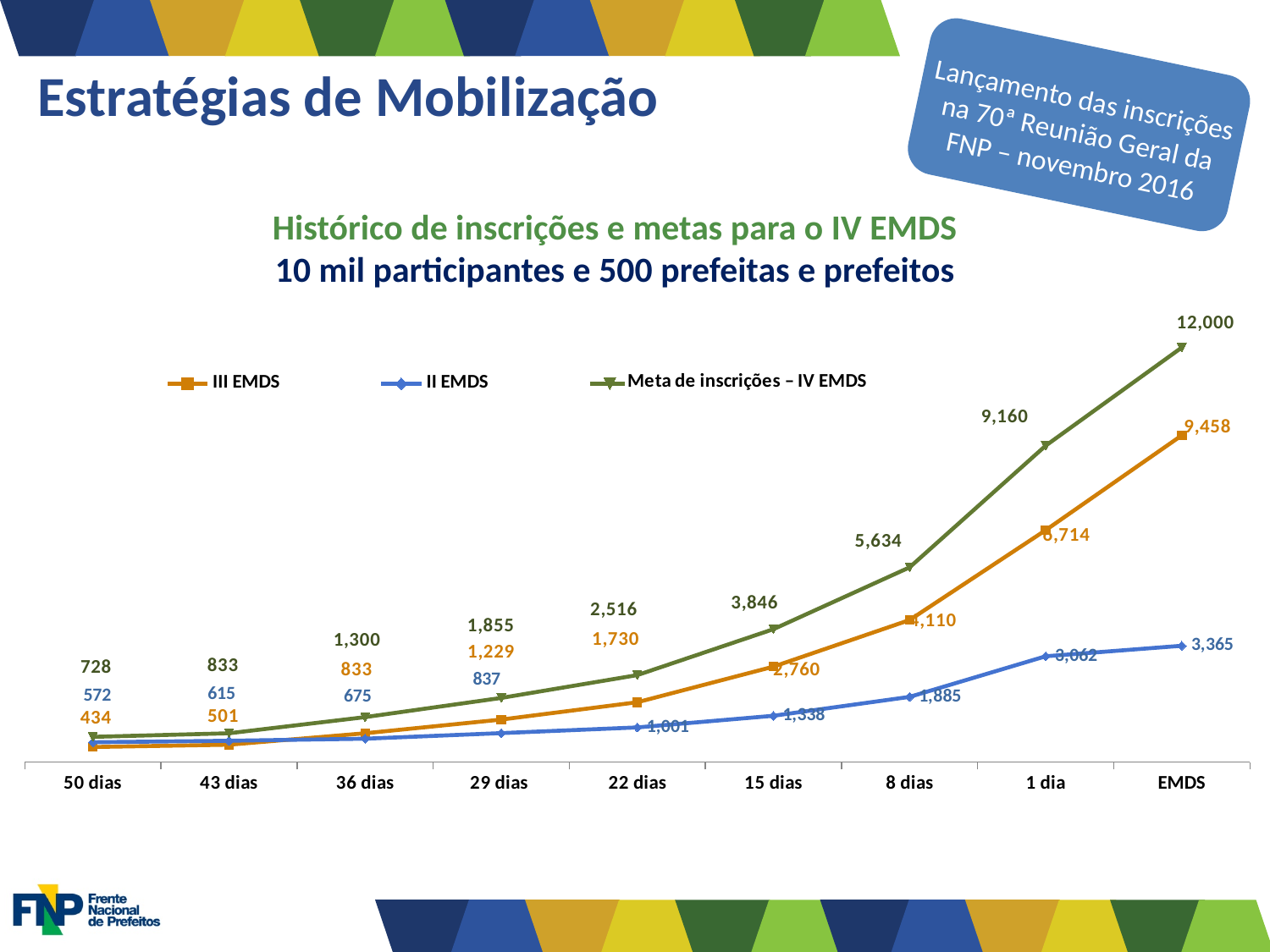
Does the Meta de inscrições – IV EMDS series rise or fall from 50 dias to EMDS? rise What kind of chart is shown on the slide? line chart What is the value of the Meta de inscrições – IV EMDS series at 8 dias? 5,634 What is the value of the II EMDS series at EMDS? 3,365 What is the difference between the Meta de inscrições – IV EMDS values at 1 dia and at 8 dias? 3,526 What is the value of the Meta de inscrições – IV EMDS series at EMDS? 12,000 What is the value of the III EMDS series at EMDS? 9,458 At 50 dias, which is larger: the II EMDS value or the III EMDS value? II EMDS Which series has the highest value at EMDS? Meta de inscrições – IV EMDS How many series does the chart legend list? 3 How many categories are shown on the x axis of the chart? 9 What is the difference between the Meta de inscrições – IV EMDS value and the III EMDS value at EMDS? 2,542